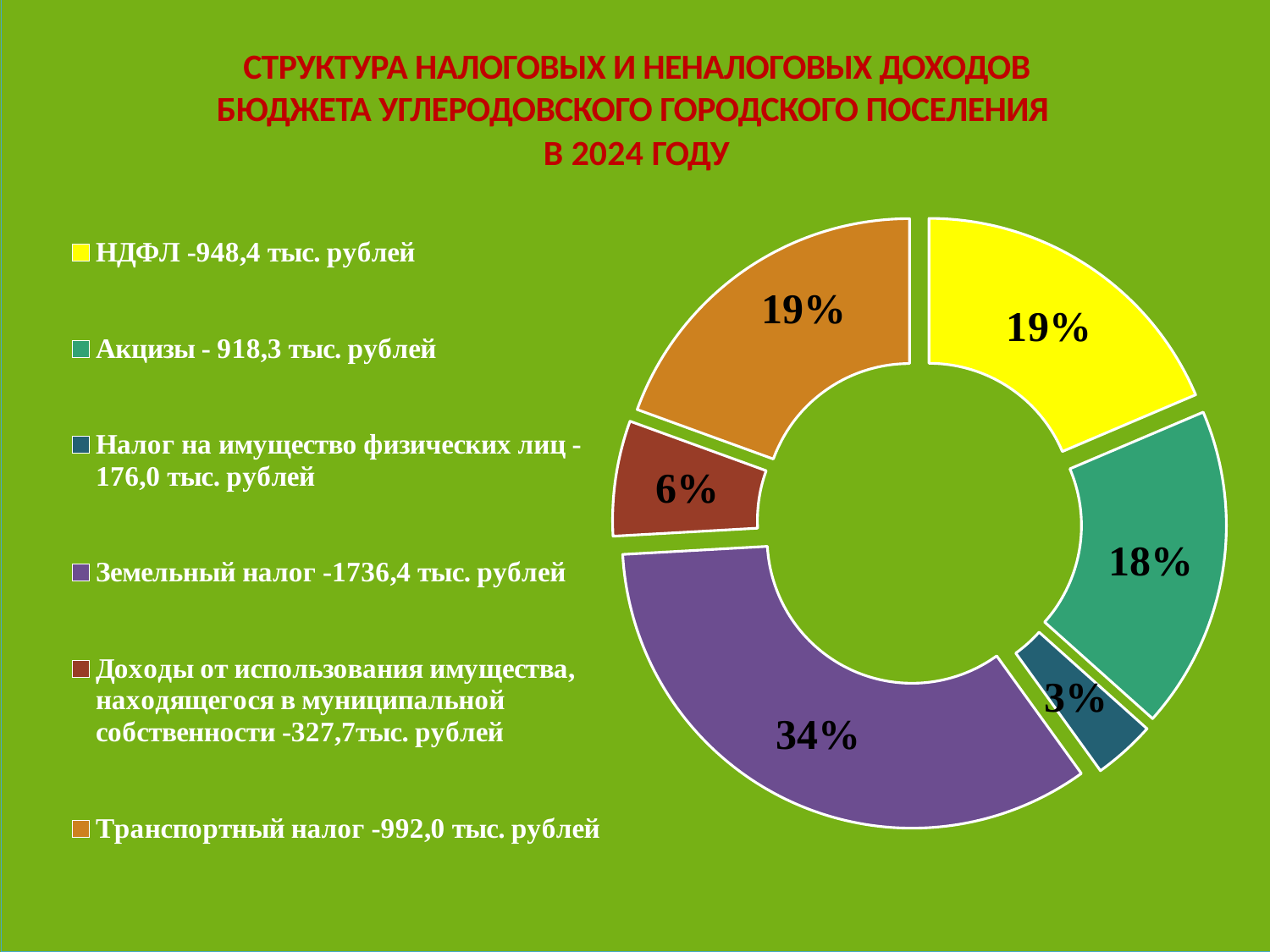
What percentage is shown for the Акцизы slice? 18% Which category has the smallest share of the chart? Налог на имущество физических лиц What amount in thousand rubles does the legend give for Транспортный налог? 992,0 тыс. рублей What is the difference in percentage points between the Земельный налог share and the Транспортный налог share? 15 What kind of chart is shown on the slide? doughnut chart Which category has the largest share of the chart? Земельный налог What percentage is shown for the НДФЛ slice? 19% What share of the chart does Земельный налог account for? 34% How many categories are shown in the chart? 6 What colour is the Земельный налог slice? purple Which has a larger share, Акцизы or Доходы от использования имущества, находящегося в муниципальной собственности? Акцизы